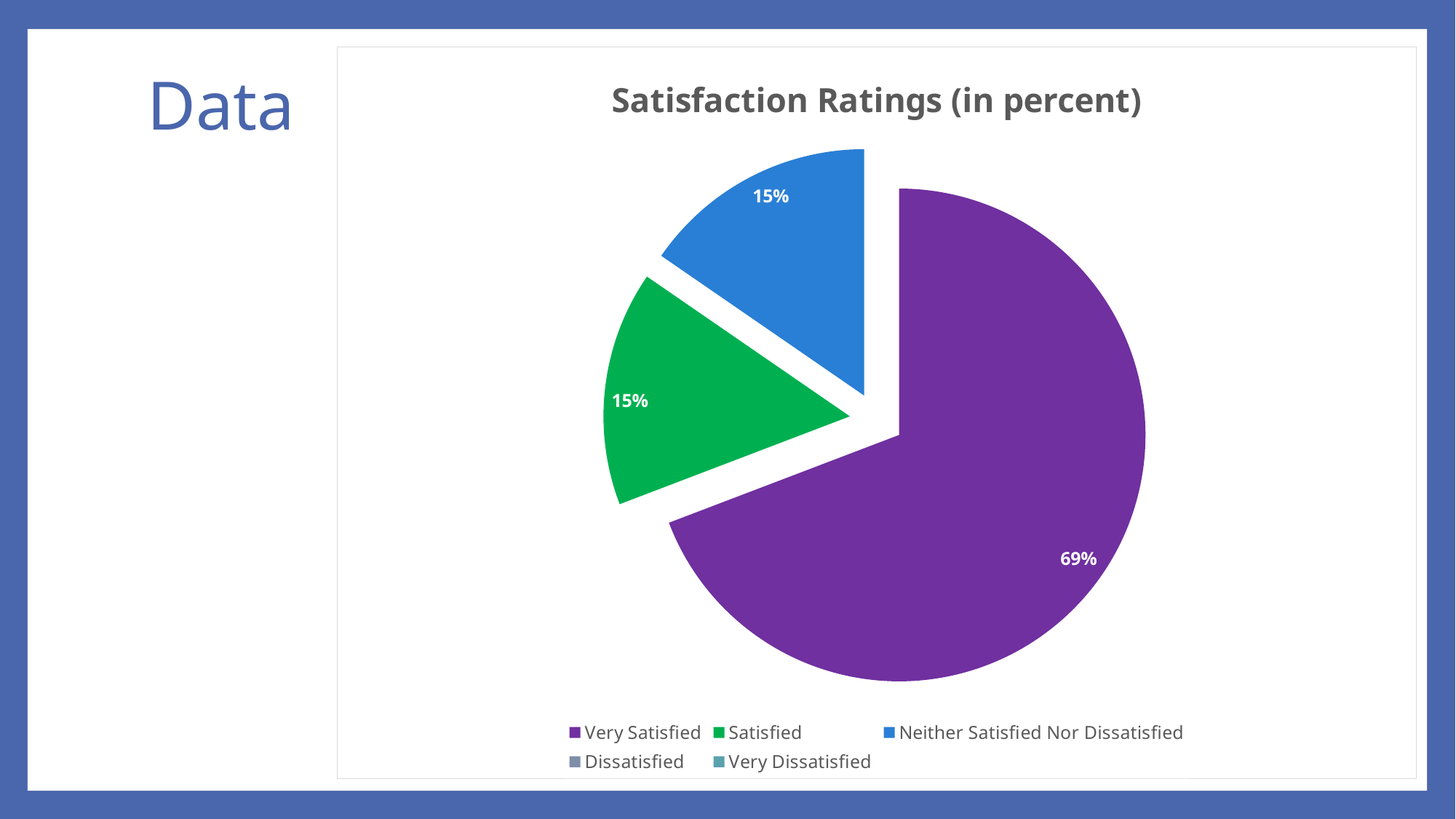
What is the difference in percentage points between the Very Satisfied and Satisfied slices? 54 Which category has the largest slice of the pie? Very Satisfied What colour is the Very Satisfied slice? Purple What is the title of the chart? Satisfaction Ratings (in percent) What percentage is shown for the Satisfied slice? 15% Which slice is larger, Very Satisfied or Neither Satisfied Nor Dissatisfied? Very Satisfied What share of the pie does the Very Satisfied slice represent? 69% What kind of chart is shown on the slide? Pie chart How many slices with data labels are visible in the pie? 3 How many categories does the legend list? 5 What percentage is shown for the Neither Satisfied Nor Dissatisfied slice? 15% What percentage of the pie is labelled for Very Satisfied? 69%